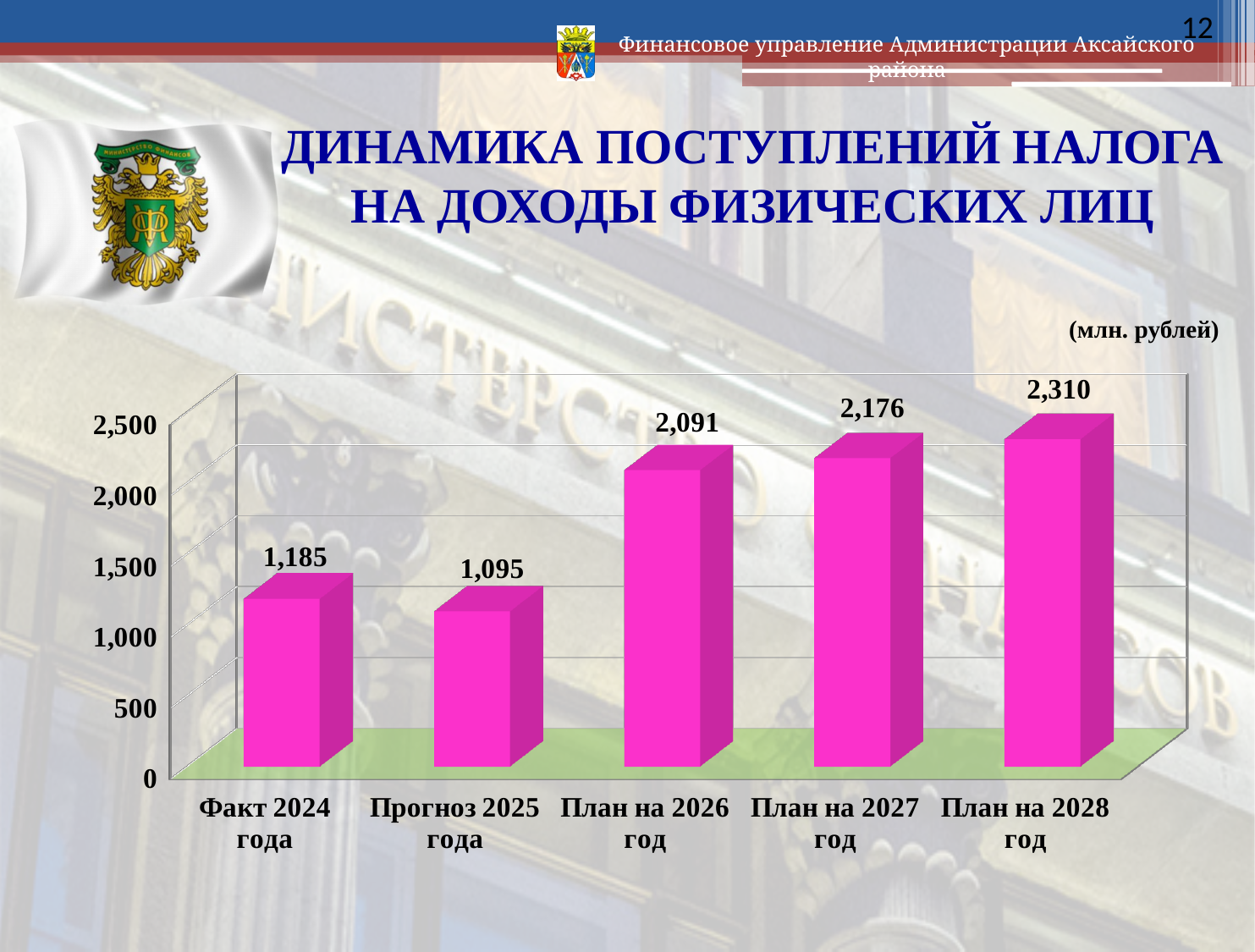
What is the value for План на 2028 год? 2,310 How many categories are shown in the chart? 5 What is the value for Прогноз 2025 года? 1,095 What is the difference between the values for Факт 2024 года and Прогноз 2025 года? 90 What is the value for Факт 2024 года? 1,185 What kind of chart is shown on the slide? bar chart Is the value for План на 2026 год greater or less than 2,000? greater Do the values rise or fall from План на 2026 год to План на 2028 год? rise Which category has the lowest value? Прогноз 2025 года Which category has the highest value? План на 2028 год What is the difference between the values for План на 2028 год and Факт 2024 года? 1,125 Which is larger, the value for План на 2027 год or the value for План на 2026 год? План на 2027 год